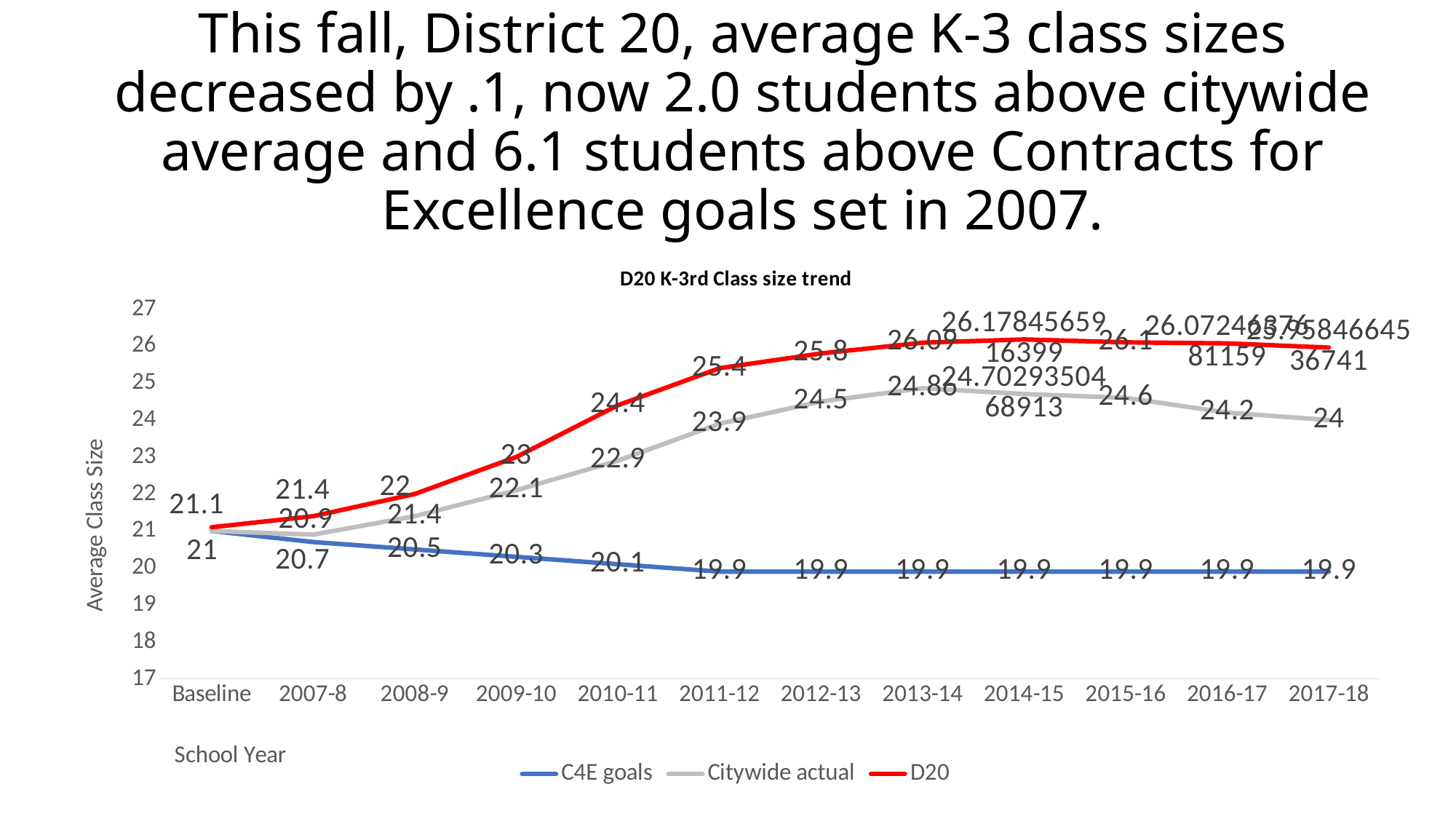
Which is larger in 2017-18, the D20 value or the C4E goals value? D20 What is the Citywide actual value for 2016-17? 24.2 Is the D20 value for 2017-18 greater or less than 25? greater How many school-year categories are shown on the x axis? 12 What is the difference between the D20 value and the Citywide actual value in 2012-13? 1.3 How many series does the legend list? 3 What is the title of the vertical axis? Average Class Size What is the D20 value for 2011-12? 25.4 What kind of chart is shown on the slide? line chart What is the D20 value for 2008-9? 22 Do the C4E goals values rise or fall from Baseline to 2011-12? fall What is the C4E goals value for 2009-10? 20.3